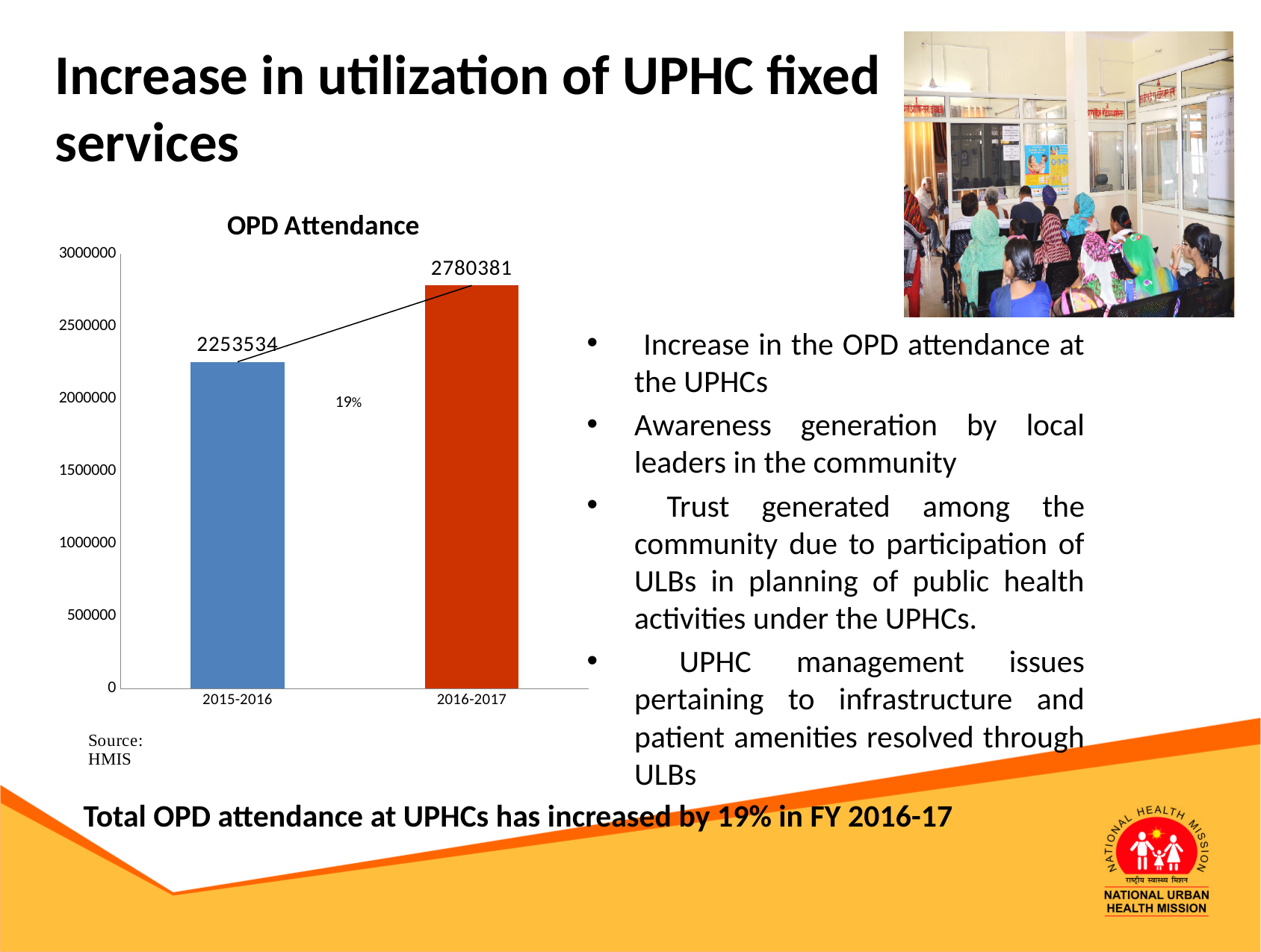
What is the OPD attendance value for 2016-2017? 2780381 Which year has the higher OPD attendance? 2016-2017 How many categories are shown on the x axis of the chart? 2 What is the title of the chart? OPD Attendance What percentage increase is annotated between the two bars on the chart? 19% Is the OPD attendance for 2015-2016 greater or less than 2500000? less What is the difference in OPD attendance between 2016-2017 and 2015-2016? 526847 Which year has the lower OPD attendance? 2015-2016 What is the OPD attendance value for 2015-2016? 2253534 Is the OPD attendance for 2016-2017 greater or less than 2500000? greater What kind of chart is shown on the slide? Bar chart Do the values rise or fall from 2015-2016 to 2016-2017? Rise